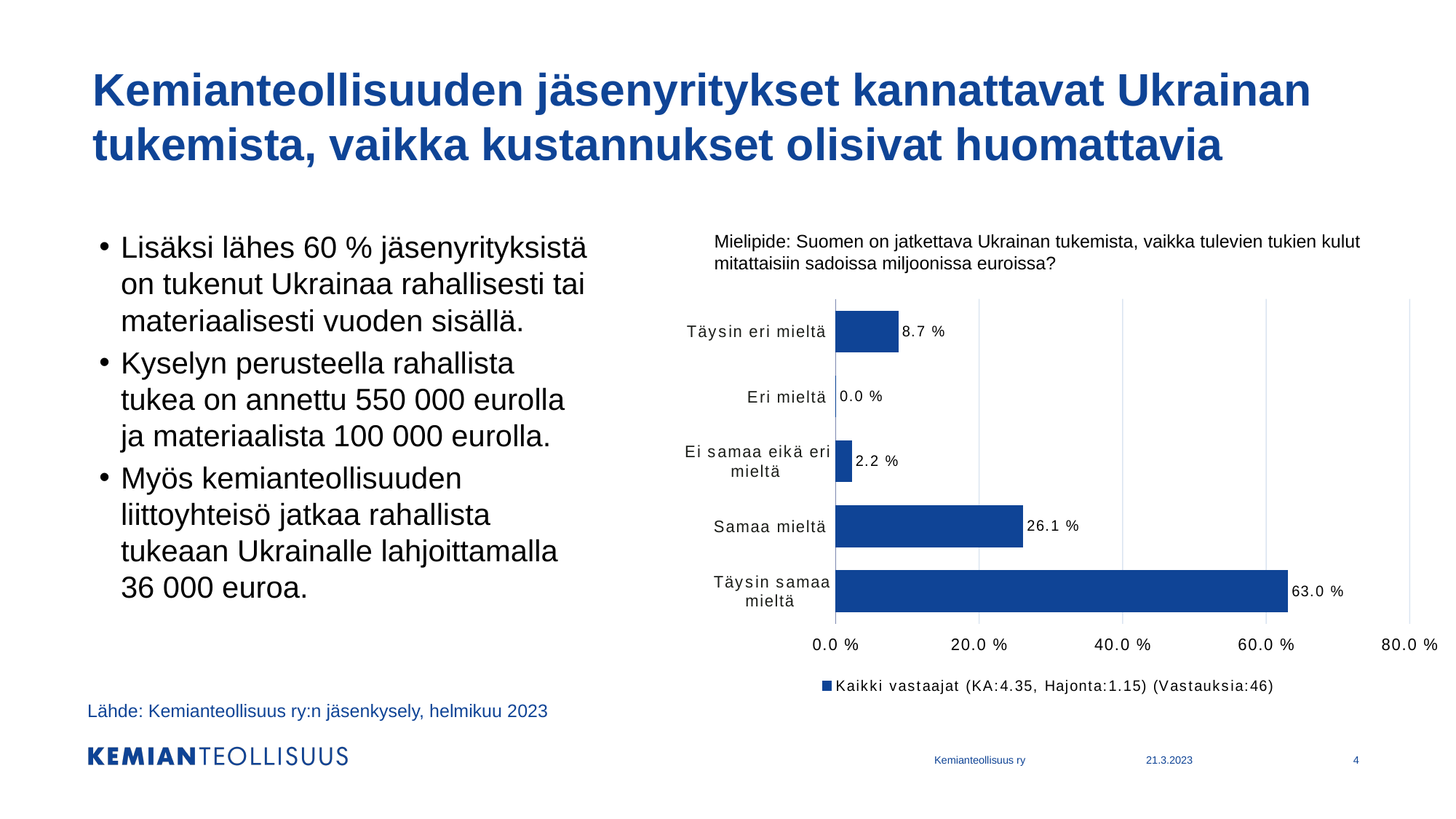
How many series does the legend list? 1 What is the value for "Täysin samaa mieltä"? 63.0 % Is the value for "Täysin samaa mieltä" greater or less than 60.0 %? greater What kind of chart is shown on the slide? bar chart What is the value for "Ei samaa eikä eri mieltä"? 2.2 % Which category has the highest value? Täysin samaa mieltä What is the difference between the values for "Täysin samaa mieltä" and "Samaa mieltä"? 36.9 % What is the value for "Samaa mieltä"? 26.1 % Which is larger, the value for "Täysin eri mieltä" or the value for "Ei samaa eikä eri mieltä"? Täysin eri mieltä What is the value for "Täysin eri mieltä"? 8.7 % Which category has the lowest value? Eri mieltä How many categories are shown on the chart? 5